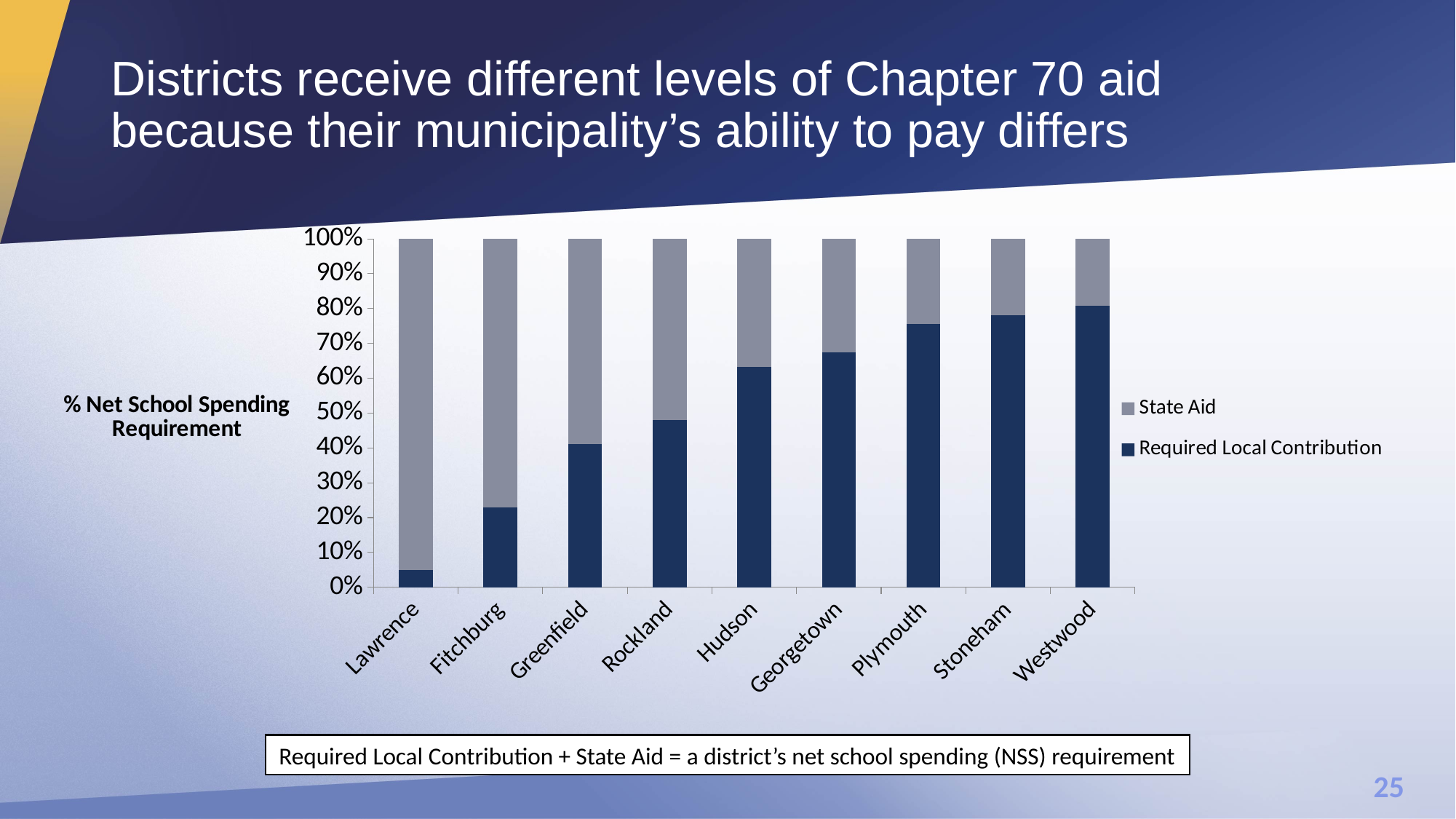
Is the Required Local Contribution for Hudson greater or less than 60%? greater Does the Required Local Contribution share rise or fall moving from Lawrence to Westwood along the x axis? rise How many series does the chart's legend list? 2 Is the Required Local Contribution for Lawrence greater or less than 10%? less Which district receives the largest share of State Aid? Lawrence What kind of chart is shown on the slide? bar chart Which district has a larger Required Local Contribution share, Hudson or Fitchburg? Hudson Is the Required Local Contribution for Stoneham greater or less than 80%? less How many districts are shown on the x axis of the chart? 9 Which district has the lowest Required Local Contribution share? Lawrence Which district has the highest Required Local Contribution share? Westwood